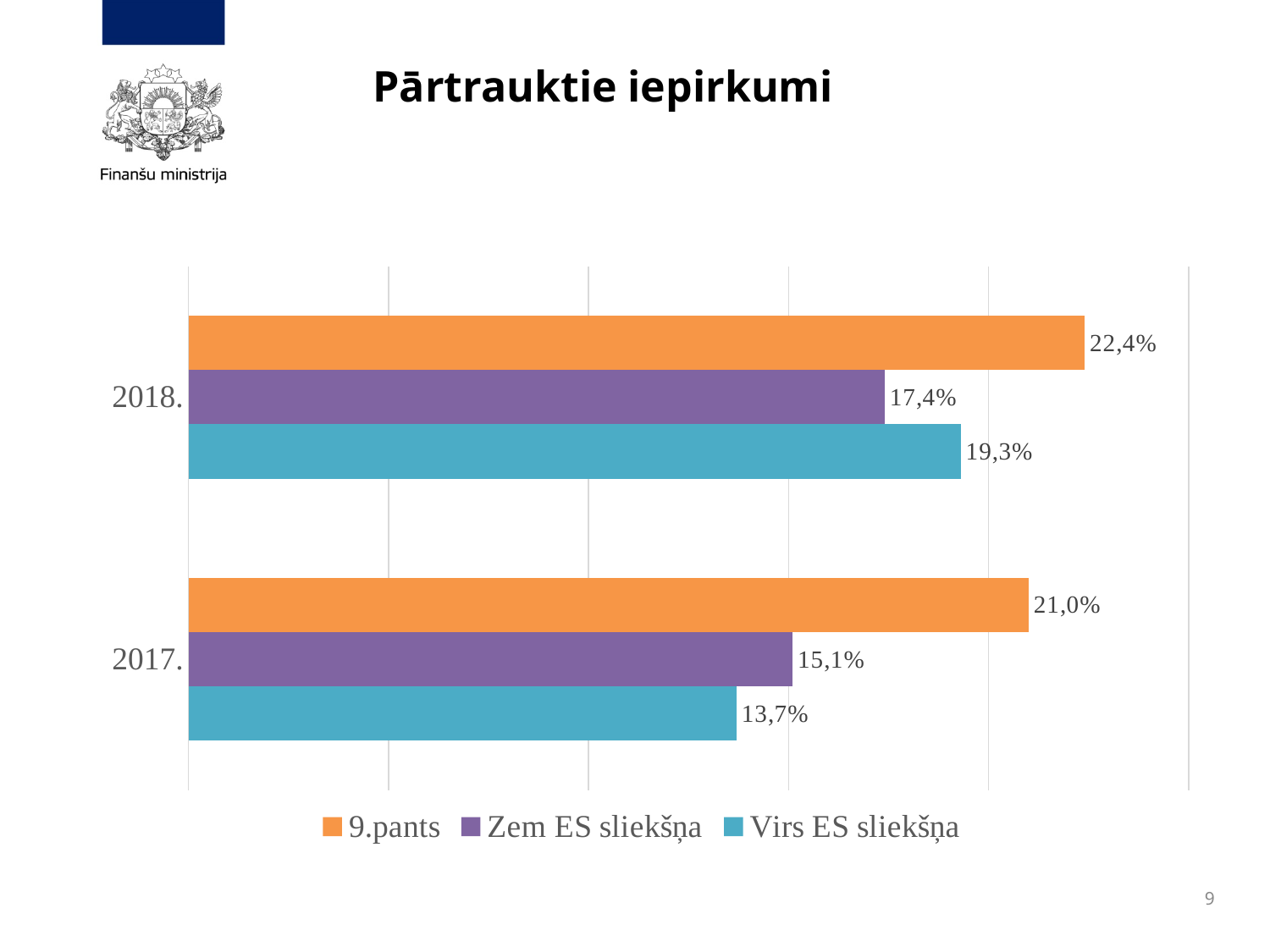
Which is larger: Zem ES sliekšņa in 2018. or Virs ES sliekšņa in 2018.? Virs ES sliekšņa in 2018. What kind of chart is shown on the slide? Bar chart What is the title of the slide containing the chart? Pārtrauktie iepirkumi What is the difference between Virs ES sliekšņa in 2018. and in 2017.? 5,6% What is the value for 9.pants in 2018.? 22,4% Which series has the highest value in 2018.? 9.pants What is the value for Virs ES sliekšņa in 2018.? 19,3% Which series has the lowest value in 2017.? Virs ES sliekšņa What is the difference between the 9.pants values for 2018. and 2017.? 1,4% How many series does the legend list? 3 What is the value for Virs ES sliekšņa in 2017.? 13,7% What is the value for Zem ES sliekšņa in 2017.? 15,1%